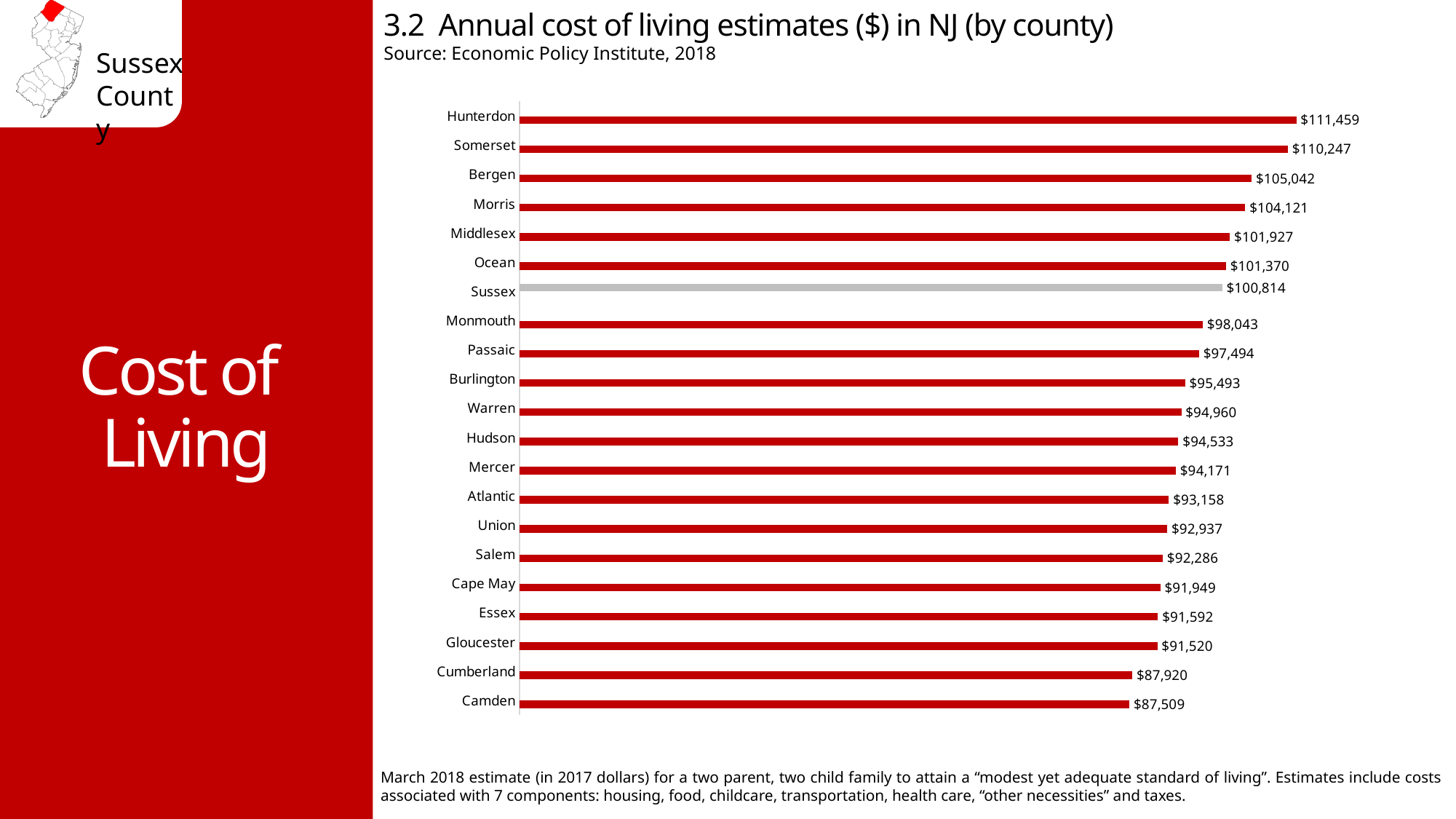
Which county has the lowest annual cost of living estimate? Camden How many counties are shown in the chart? 21 What is the difference between the cost of living estimates for Sussex and Camden? $13,305 Which county has a higher cost of living estimate, Morris or Middlesex? Morris Which county has the highest annual cost of living estimate? Hunterdon Which county's bar is shown in a different colour (grey) from the others? Sussex What is the annual cost of living estimate for Camden County? $87,509 What is the annual cost of living estimate for Sussex County? $100,814 What is the difference between the cost of living estimates for Hunterdon and Somerset? $1,212 What type of chart is used on this slide? Bar chart What is the annual cost of living estimate for Bergen County? $105,042 What is the source cited for the chart data? Economic Policy Institute, 2018